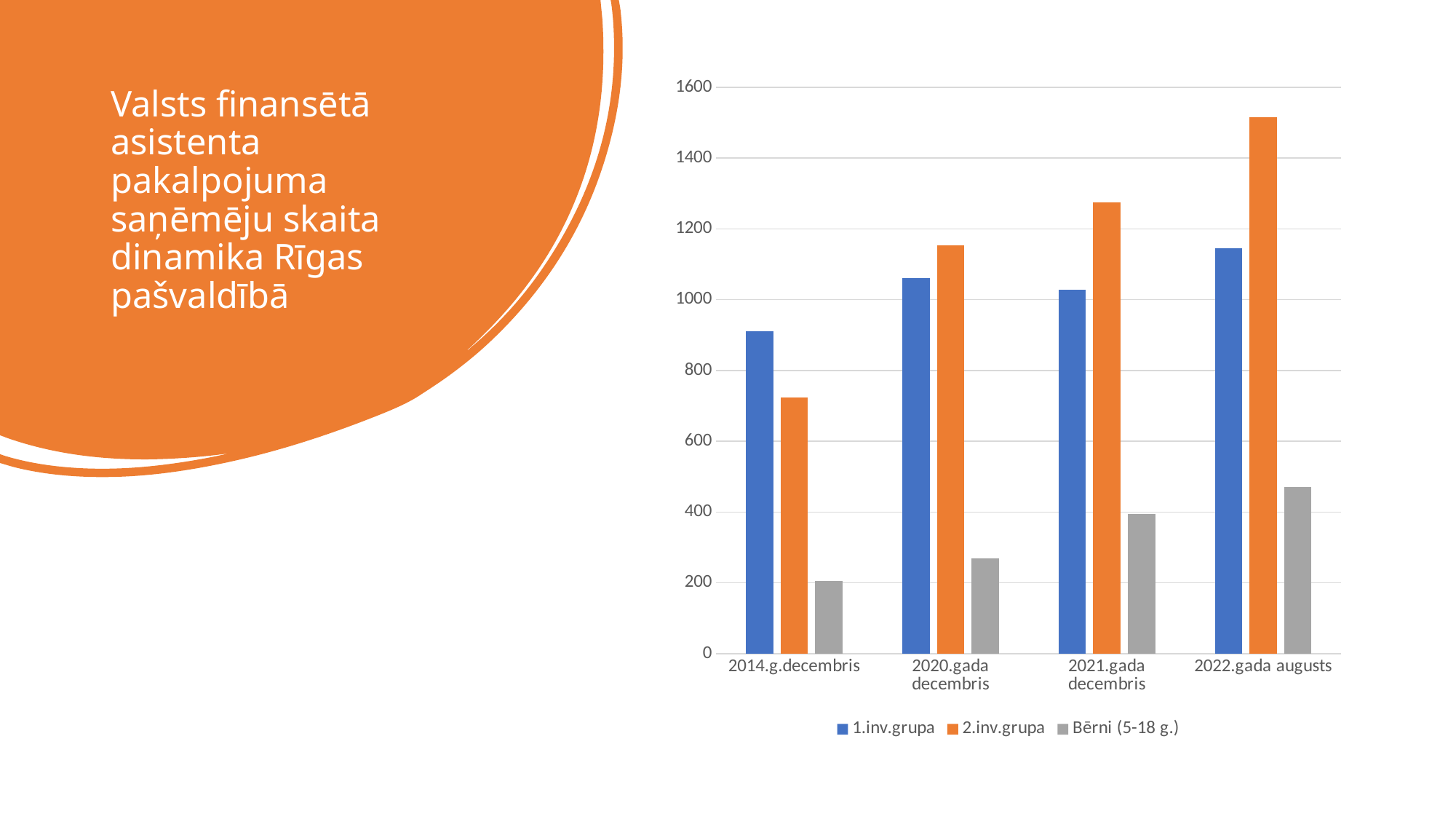
What kind of chart is shown on the slide? Bar chart How many series does the legend list? 3 In 2014.g.decembris, which is larger: 1.inv.grupa or 2.inv.grupa? 1.inv.grupa Is the value for Bērni (5-18 g.) in 2022.gada augusts greater or less than 400? greater In 2022.gada augusts, which is larger: 1.inv.grupa or 2.inv.grupa? 2.inv.grupa Do the values for 2.inv.grupa rise or fall from 2014.g.decembris to 2022.gada augusts? rise Which category has the highest value for 2.inv.grupa? 2022.gada augusts Which category has the lowest value for Bērni (5-18 g.)? 2014.g.decembris How many categories are shown on the x axis? 4 Is the value for 2.inv.grupa in 2022.gada augusts greater or less than 1400? greater Which series is shown in grey in the legend? Bērni (5-18 g.) Is the value for 2.inv.grupa in 2014.g.decembris greater or less than 800? less